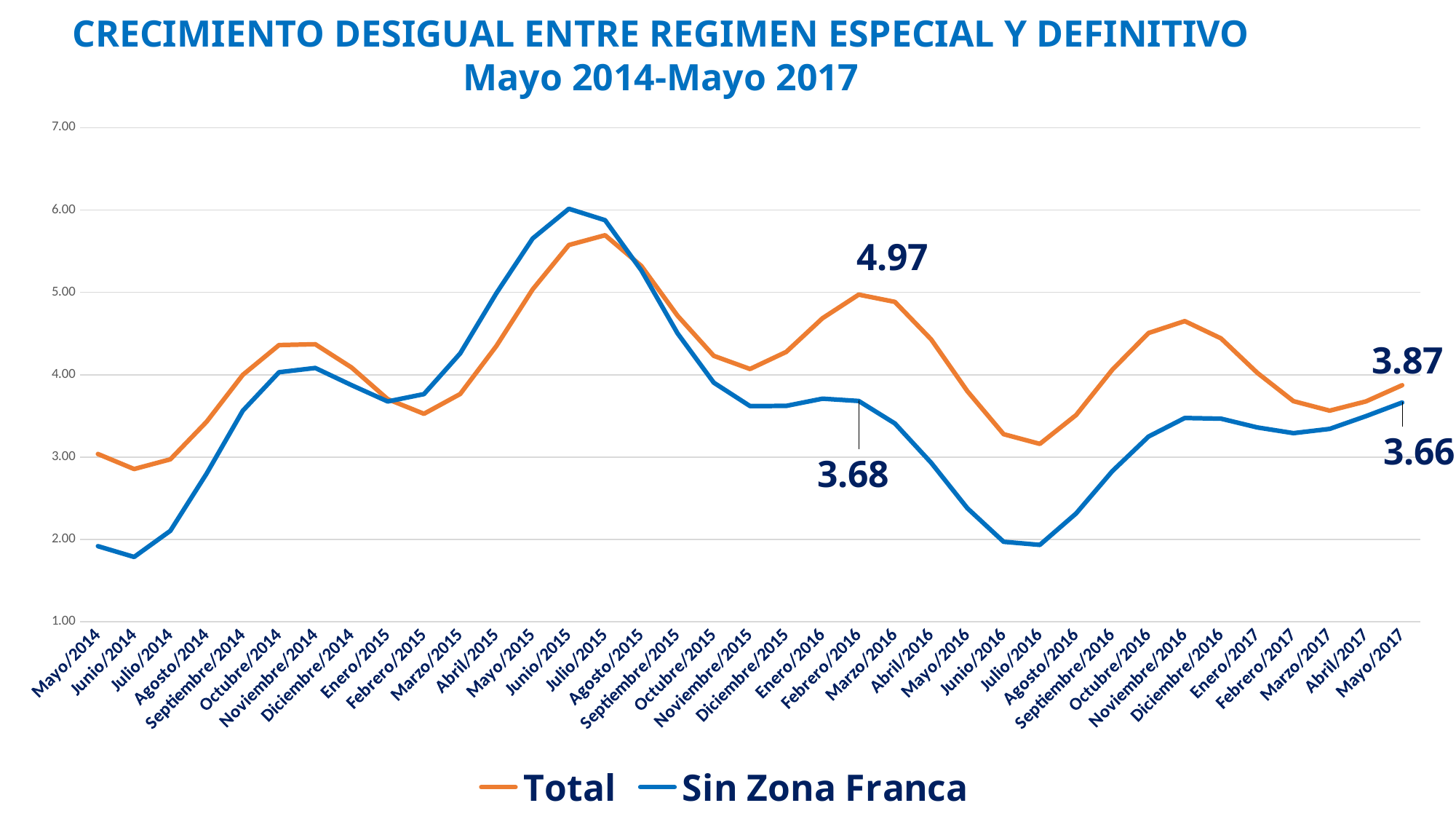
In which month does the Sin Zona Franca series reach its highest value? Junio/2015 In Febrero/2016, which series has the larger value, Total or Sin Zona Franca? Total What is the value of the Total series in Febrero/2016? 4.97 Is the value for Total in Julio/2015 greater or less than 5.00? greater What is the value of the Sin Zona Franca series in Mayo/2017? 3.66 What is the value of the Total series in Mayo/2017? 3.87 What is the value of the Sin Zona Franca series in Febrero/2016? 3.68 How many series does the legend list? 2 What kind of chart is shown on the slide? Line chart Is the value for Sin Zona Franca in Junio/2014 greater or less than 2.00? less What is the difference between the Total and Sin Zona Franca values in Mayo/2017? 0.21 What is the difference between the Total and Sin Zona Franca values in Febrero/2016? 1.29